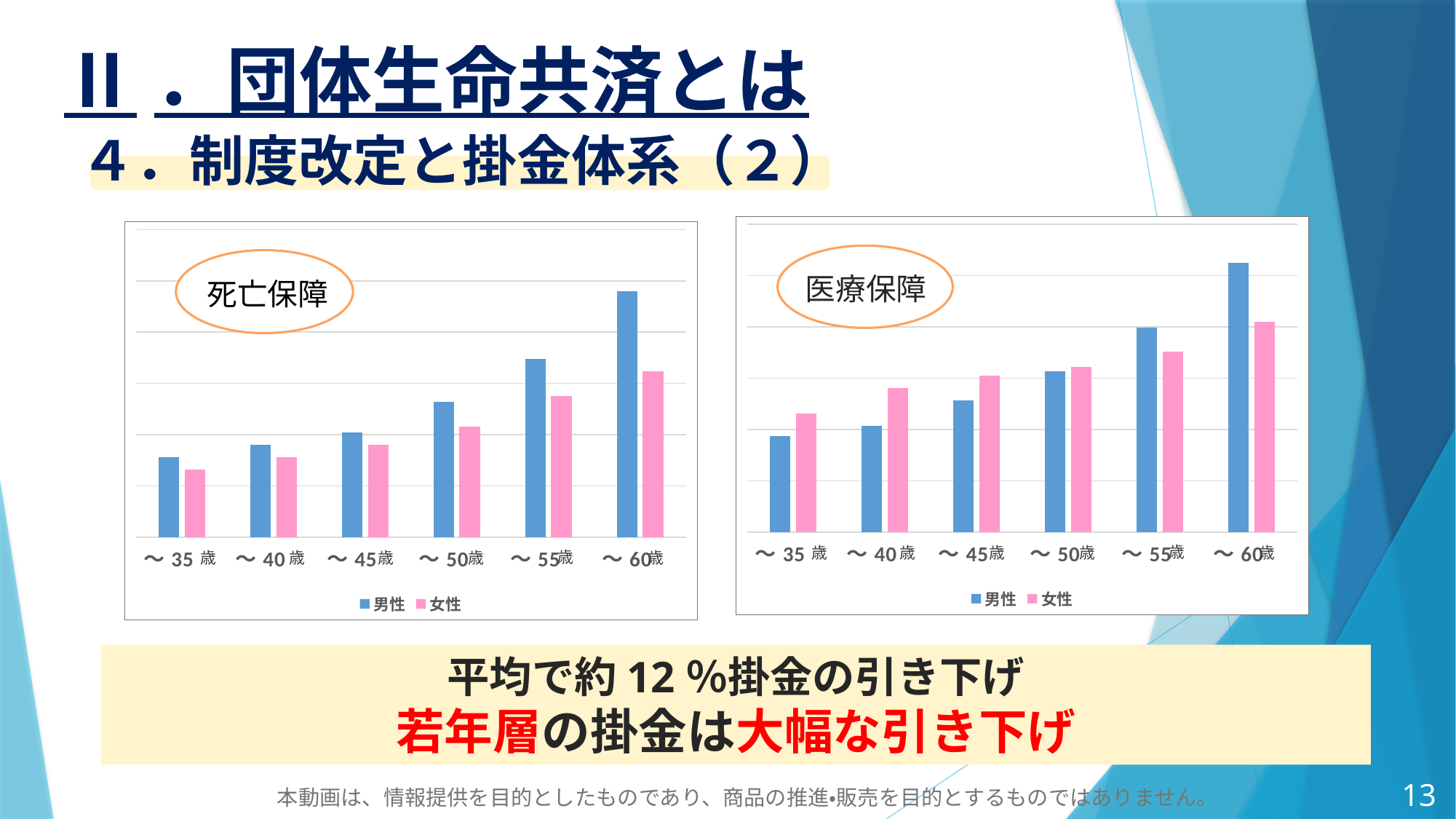
In the 死亡保障 chart, which age category has the highest 男性 bar? ～60歳 In the 医療保障 chart, at ～60歳, which is larger, 男性 or 女性? 男性 How many series does the legend of the 死亡保障 chart list? 2 In the 医療保障 chart, which age category has the highest 男性 bar? ～60歳 In the 死亡保障 chart, do the 男性 values rise or fall as age increases along the x axis? rise In the 医療保障 chart, which age category has the lowest 男性 bar? ～35歳 What colour represents 女性 in the legend of the 医療保障 chart? pink In the 死亡保障 chart, which age category has the lowest 女性 bar? ～35歳 In the 死亡保障 chart, at ～60歳, which is larger, 男性 or 女性? 男性 What kind of chart is the 死亡保障 chart on the left? bar chart In the 医療保障 chart, at ～35歳, which is larger, 男性 or 女性? 女性 How many age categories are shown on the x axis of the 医療保障 chart? 6